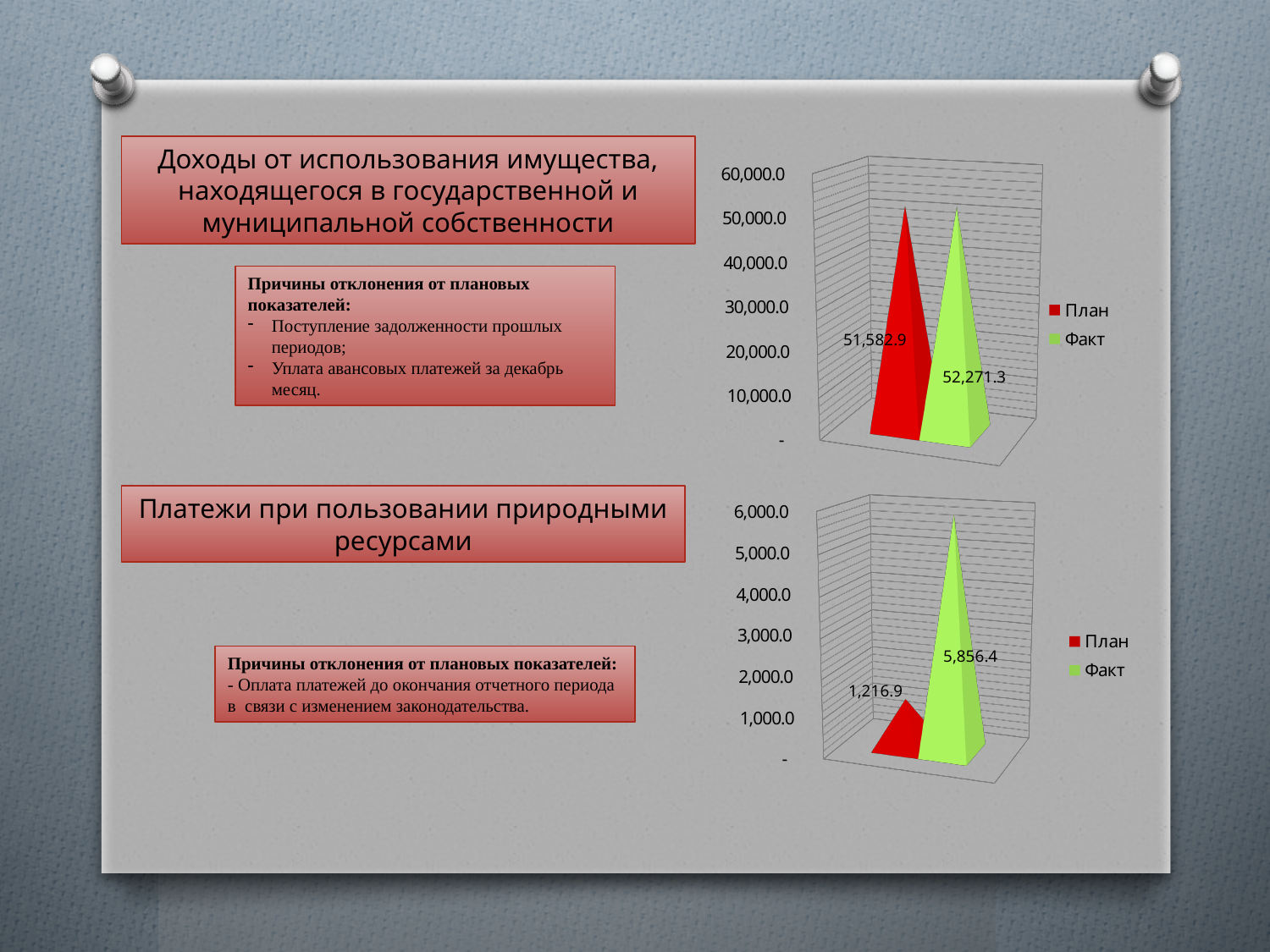
In the bottom chart (Платежи при пользовании природными ресурсами), what is the value for Факт? 5,856.4 How many series does the legend of the top chart list? 2 In the bottom chart, which series has the higher value, План or Факт? Факт In the top chart (Доходы от использования имущества), what is the value for Факт? 52,271.3 In the bottom chart (Платежи при пользовании природными ресурсами), what is the value for План? 1,216.9 What kind of chart is the bottom chart? Bar chart In the bottom chart, is the value for План greater or less than 2,000.0? less In the bottom chart, is the value for Факт greater or less than 5,000.0? greater In the top chart, which series has the higher value, План or Факт? Факт In the bottom chart, what is the difference between the Факт and План values? 4,639.5 In the top chart, what is the difference between the Факт and План values? 688.4 In the top chart (Доходы от использования имущества), what is the value for План? 51,582.9